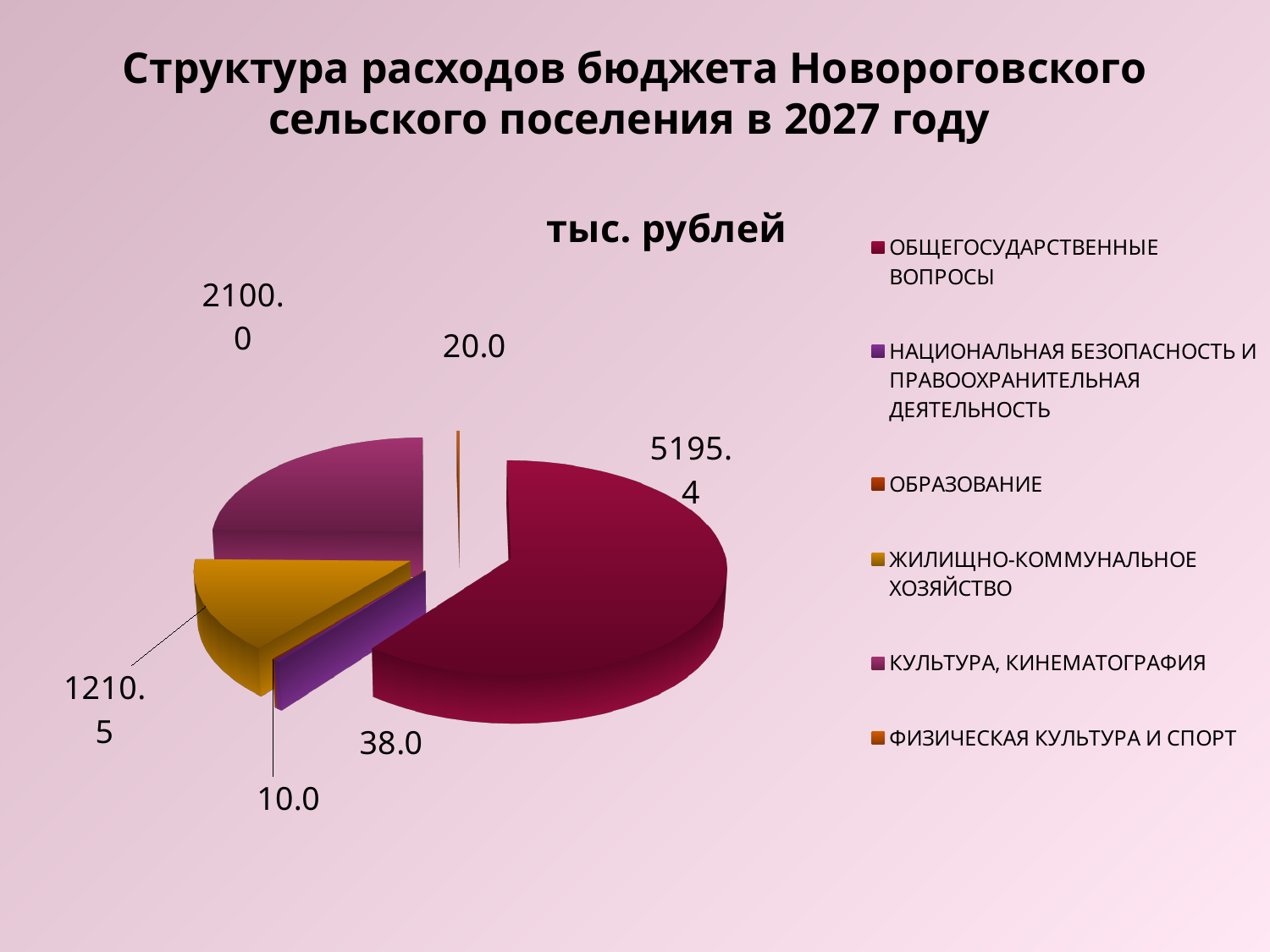
What is the difference between the values for КУЛЬТУРА, КИНЕМАТОГРАФИЯ and ЖИЛИЩНО-КОММУНАЛЬНОЕ ХОЗЯЙСТВО? 889.5 What kind of chart is shown on the slide? pie chart What is the value for ОБЩЕГОСУДАРСТВЕННЫЕ ВОПРОСЫ? 5195.4 What is the smallest value labelled on the pie chart? 10.0 Which is larger, КУЛЬТУРА, КИНЕМАТОГРАФИЯ or ЖИЛИЩНО-КОММУНАЛЬНОЕ ХОЗЯЙСТВО? КУЛЬТУРА, КИНЕМАТОГРАФИЯ What colour is the slice for ЖИЛИЩНО-КОММУНАЛЬНОЕ ХОЗЯЙСТВО? gold What is the difference between the values for ОБЩЕГОСУДАРСТВЕННЫЕ ВОПРОСЫ and КУЛЬТУРА, КИНЕМАТОГРАФИЯ? 3095.4 How many categories does the legend list? 6 Which category has the largest slice of the pie? ОБЩЕГОСУДАРСТВЕННЫЕ ВОПРОСЫ What is the title of the chart? тыс. рублей What is the value for КУЛЬТУРА, КИНЕМАТОГРАФИЯ? 2100.0 What is the value for ЖИЛИЩНО-КОММУНАЛЬНОЕ ХОЗЯЙСТВО? 1210.5